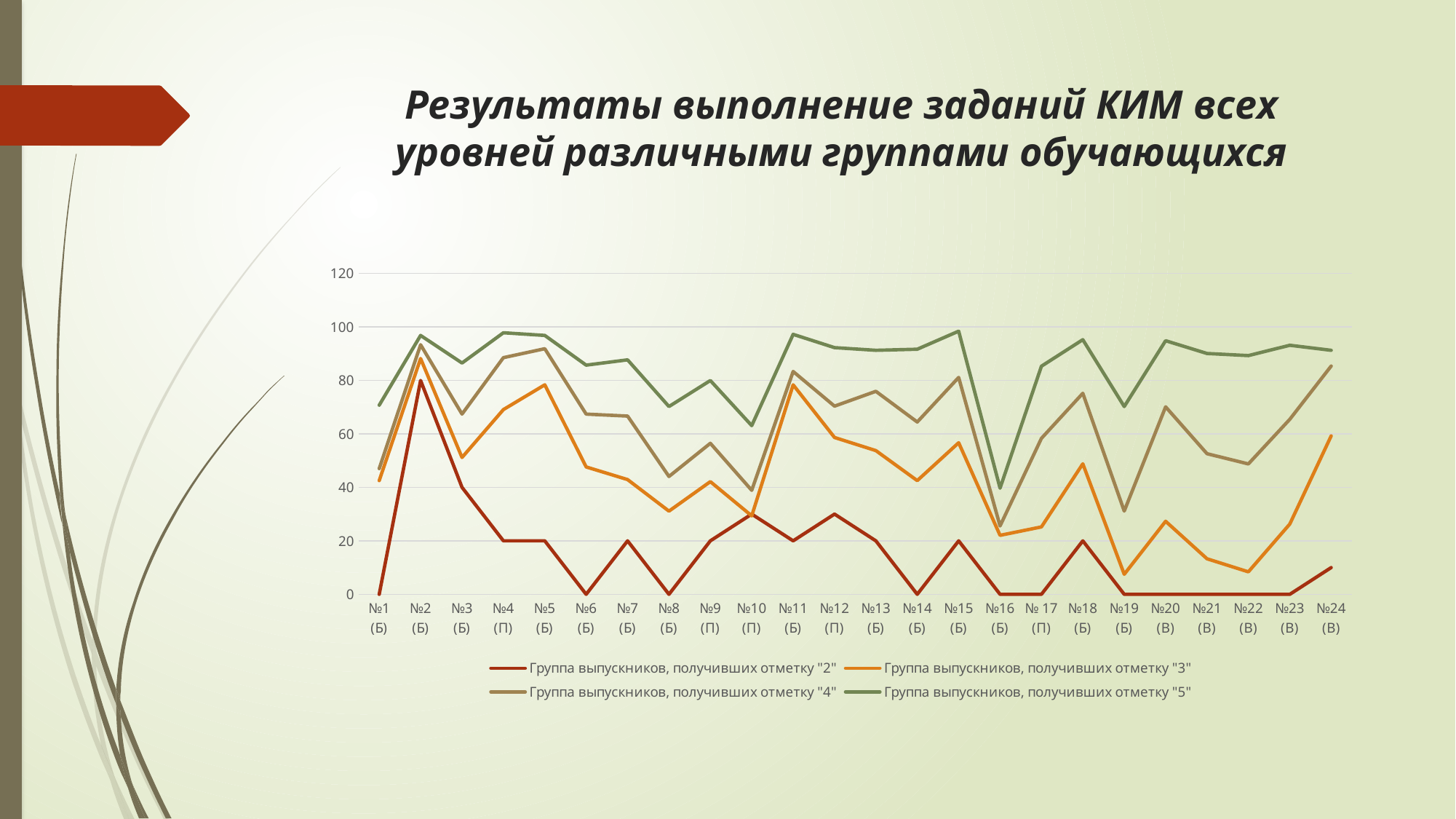
At which task does the series Группа выпускников, получивших отметку "5" reach its lowest value? №16 (Б) How many series does the legend list? 4 How many task categories are plotted along the x axis? 24 Does the series Группа выпускников, получивших отметку "2" rise or fall from task №1 (Б) to task №2 (Б)? rise What is the value for task №2 (Б) for the series Группа выпускников, получивших отметку "2"? 80 What is the value for task №1 (Б) for the series Группа выпускников, получивших отметку "2"? 0 Is the value for task №2 (Б) for the series Группа выпускников, получивших отметку "5" greater or less than 80? greater Is the value for task №16 (Б) for the series Группа выпускников, получивших отметку "4" greater or less than 40? less What kind of chart is shown on the slide? line chart At task №1 (Б), which series has the larger value: Группа выпускников, получивших отметку "5" or Группа выпускников, получивших отметку "3"? Группа выпускников, получивших отметку "5" Which colour is used for the series Группа выпускников, получивших отметку "5"? green At which task does the series Группа выпускников, получивших отметку "3" reach its highest value? №2 (Б)